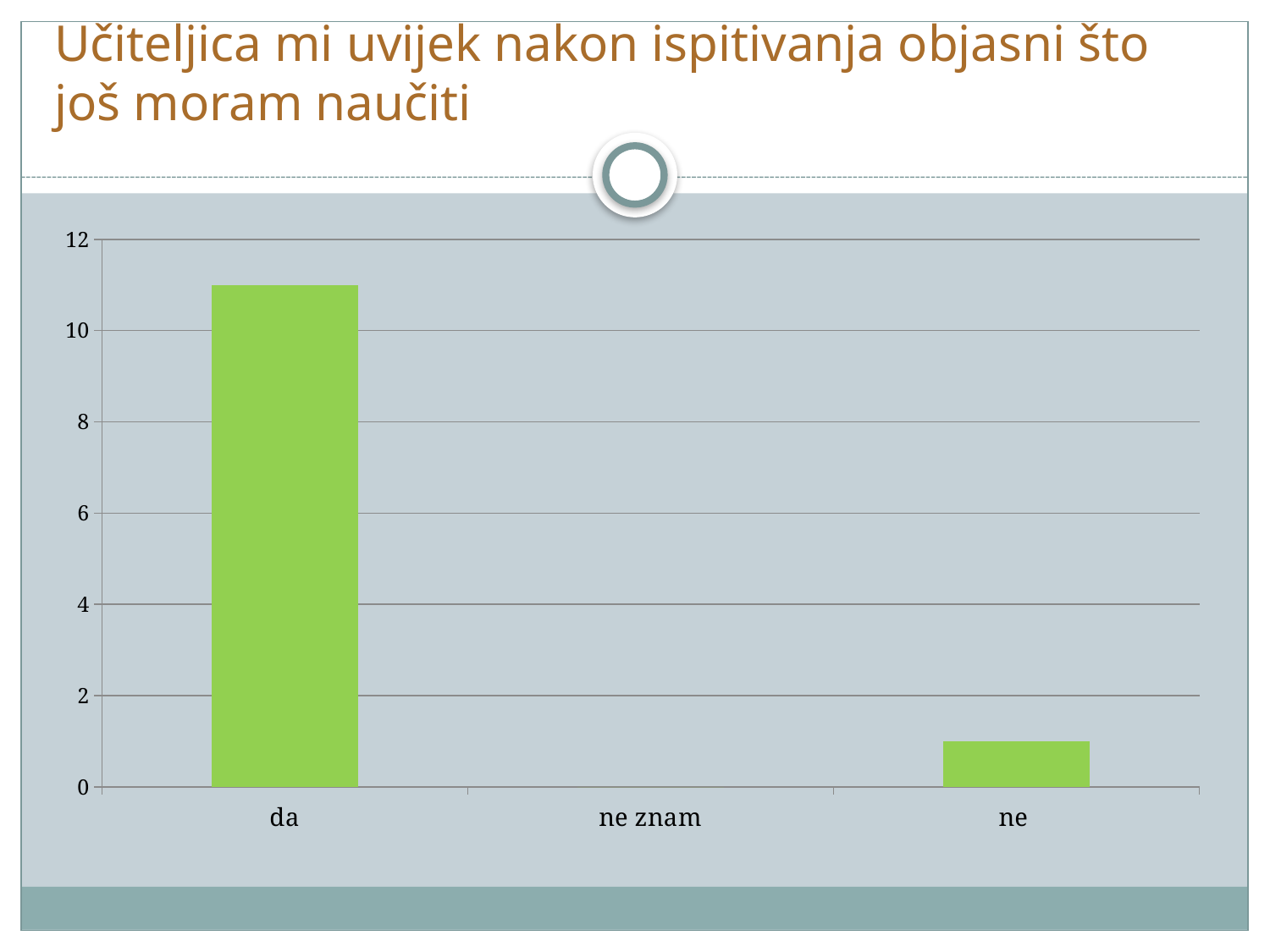
Which is larger, the value for "ne" or the value for "ne znam"? ne Which category has the highest bar in the chart? da What is the highest value labelled on the vertical axis of the chart? 12 Which category has the lowest value in the chart? ne znam Is the value for "ne" greater or less than 2? less Is the value for "da" greater or less than 10? greater What is the title of the slide containing the chart? Učiteljica mi uvijek nakon ispitivanja objasni što još moram naučiti What kind of chart is shown on the slide? bar chart Which is larger, the value for "da" or the value for "ne"? da How many categories are shown on the x axis of the chart? 3 Is the value for "da" greater or less than 12? less What is the value shown for "ne znam" in the chart? 0